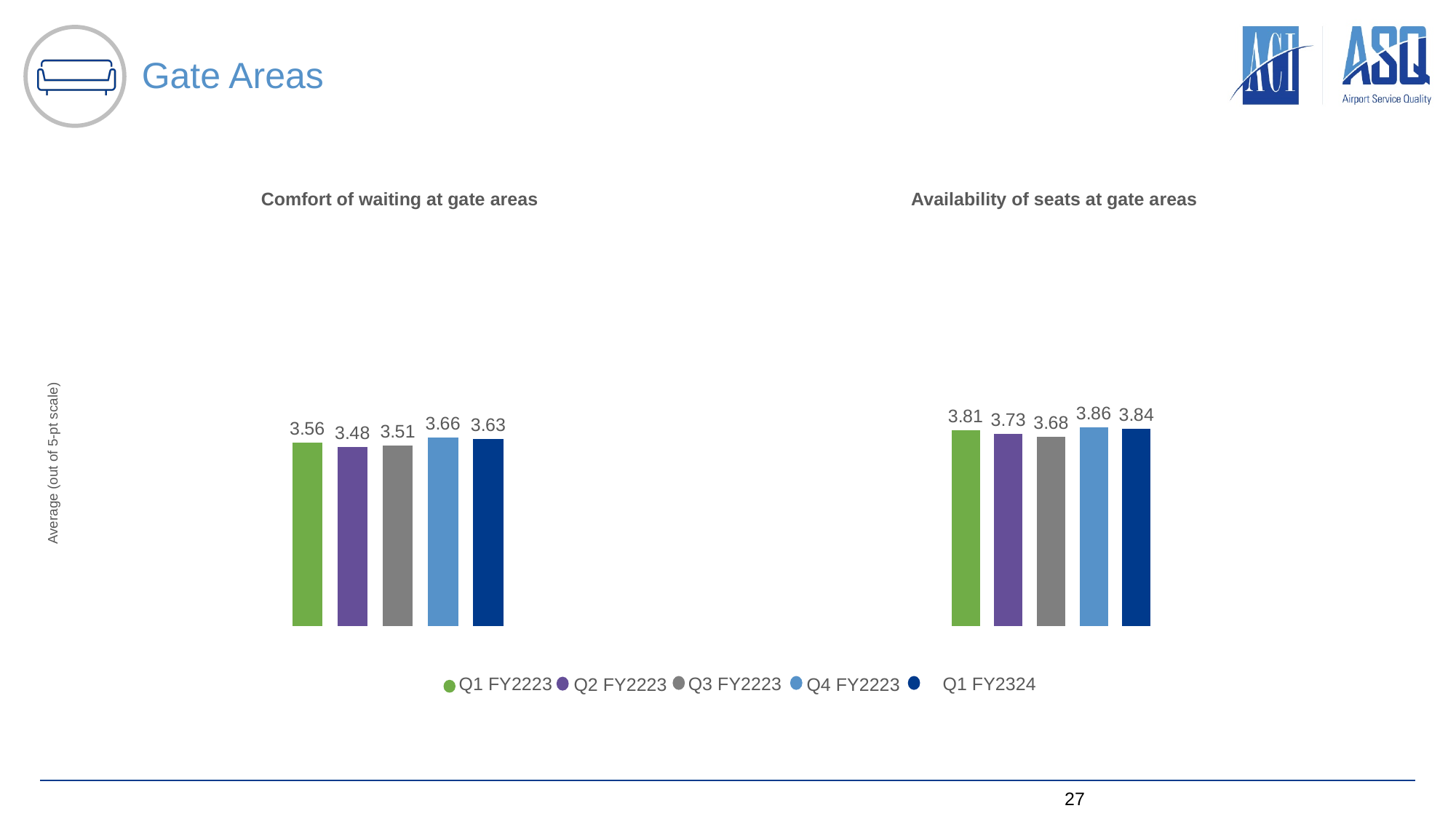
In the 'Comfort of waiting at gate areas' chart, what is the value for Q1 FY2223? 3.56 How many series does the legend list? 5 What type of chart is shown on the slide? Bar chart Which is larger: the Q1 FY2324 value for 'Comfort of waiting at gate areas' or the Q1 FY2324 value for 'Availability of seats at gate areas'? Availability of seats at gate areas In the 'Comfort of waiting at gate areas' chart, which quarter has the lowest value? Q2 FY2223 In the 'Availability of seats at gate areas' chart, what is the difference between the Q4 FY2223 and Q2 FY2223 values? 0.13 In the 'Comfort of waiting at gate areas' chart, what is the difference between the Q1 FY2324 and Q1 FY2223 values? 0.07 In the 'Availability of seats at gate areas' chart, what is the value for Q3 FY2223? 3.68 In the 'Availability of seats at gate areas' chart, which quarter has the lowest value? Q3 FY2223 In the 'Comfort of waiting at gate areas' chart, what is the value for Q1 FY2324? 3.63 In the 'Comfort of waiting at gate areas' chart, which quarter has the highest value? Q4 FY2223 In the 'Availability of seats at gate areas' chart, what is the value for Q4 FY2223? 3.86